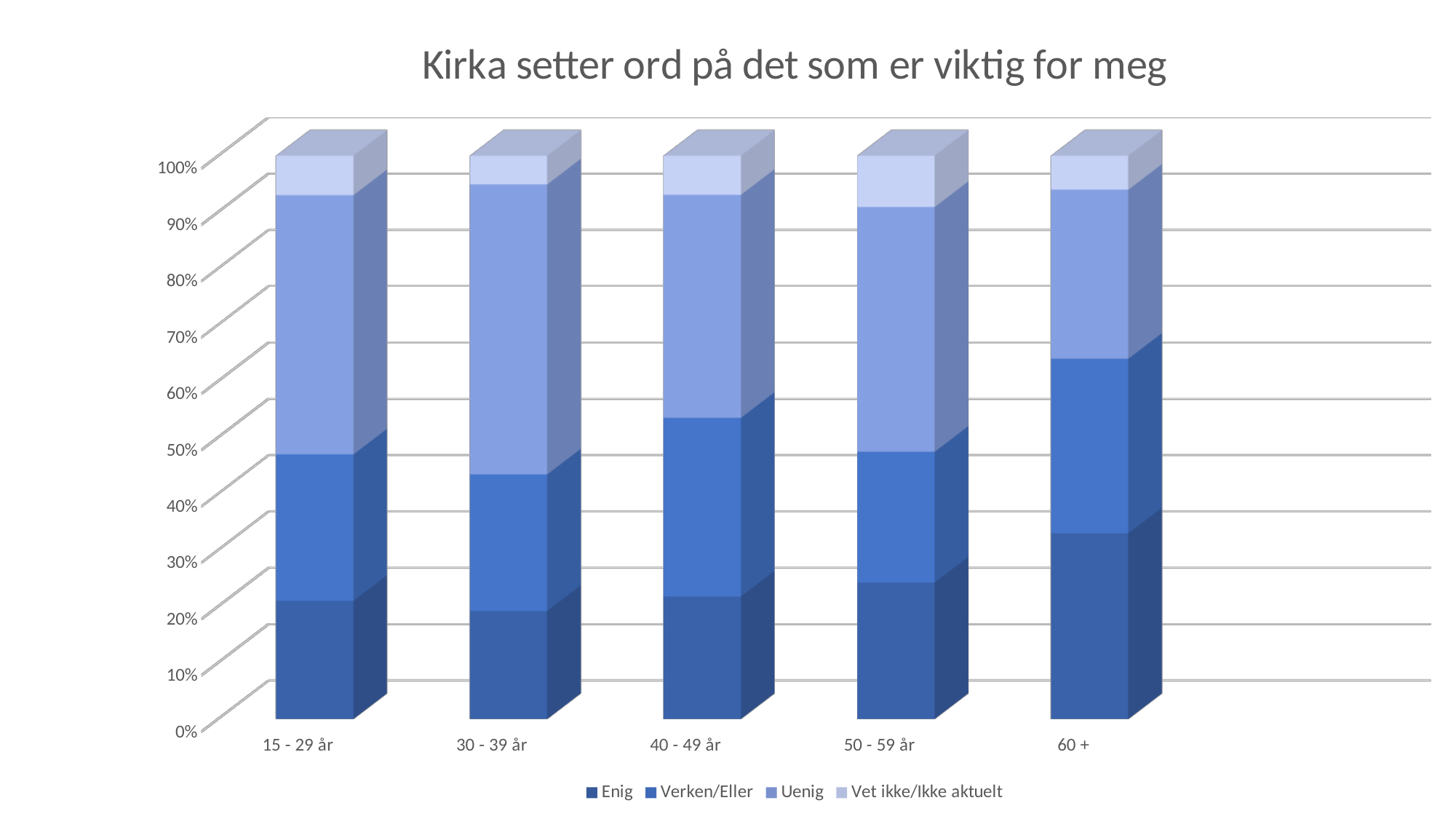
What kind of chart is shown on the slide? Stacked bar chart Which has the larger 'Verken/Eller' segment, 30 - 39 år or 40 - 49 år? 40 - 49 år Which age group has the largest 'Uenig' segment? 30 - 39 år Is the 'Enig' segment for 60 + greater or less than 30%? greater Which has the larger 'Enig' segment, 15 - 29 år or 60 +? 60 + How many series does the legend list? 4 What is the title of the chart? Kirka setter ord på det som er viktig for meg Is the 'Enig' segment for 50 - 59 år greater or less than 20%? greater Which age group has the largest 'Enig' segment? 60 + Which age group has the smallest 'Uenig' segment? 60 + How many age groups are shown on the x axis? 5 Is the 'Uenig' segment for 60 + greater or less than 40%? less